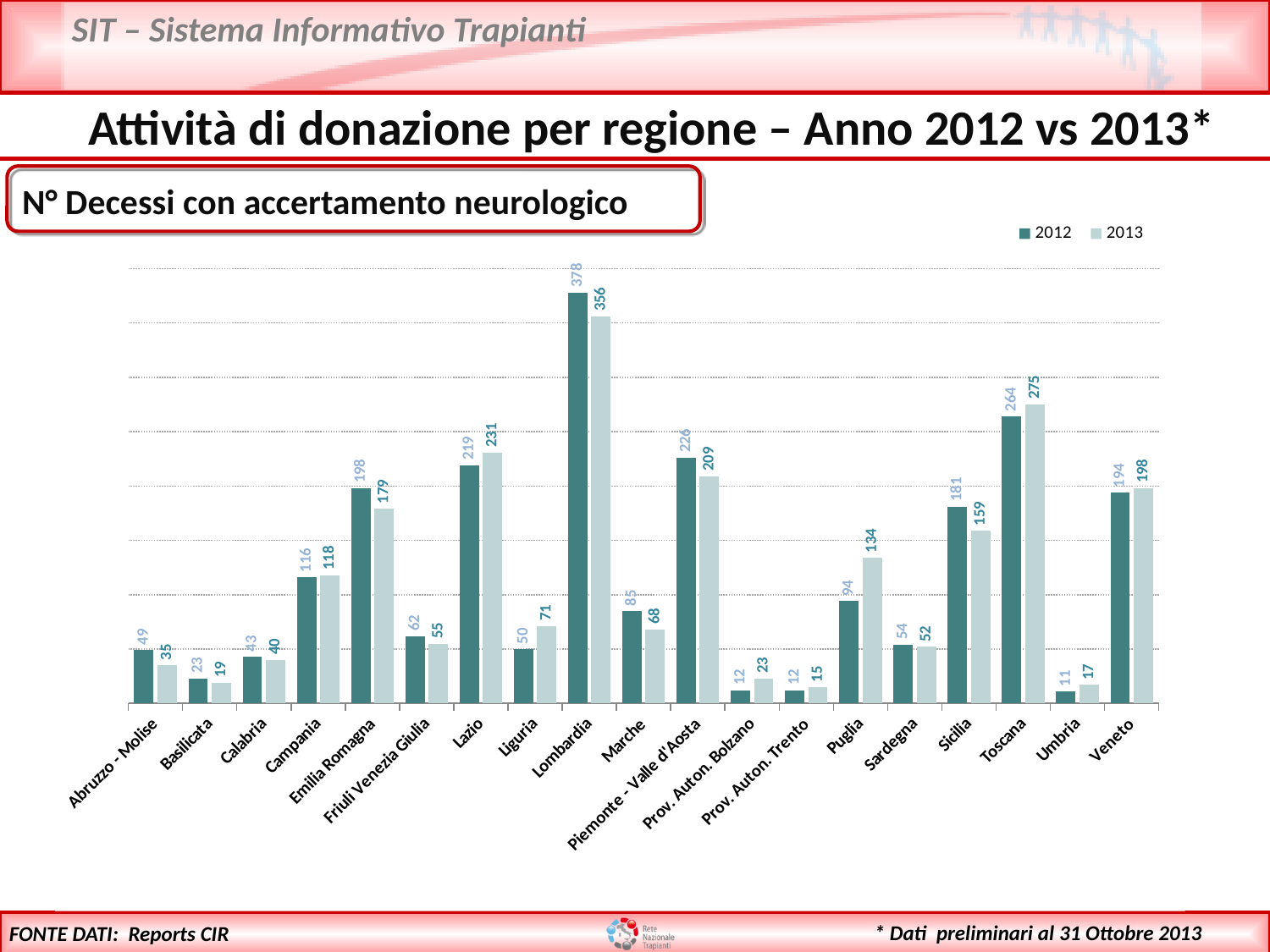
Which region has the lowest value in 2012? Umbria How many series does the legend list? 2 Which is larger for Sicilia, the 2012 value or the 2013 value? 2012 How many regions are shown on the x axis? 19 What is the difference between the 2012 and 2013 values for Lombardia? 22 Which region has the highest value in 2013? Lombardia What kind of chart is shown on the slide? Bar chart What is the difference between the 2013 and 2012 values for Puglia? 40 What is the value for Puglia in 2013? 134 What is the value for Lombardia in 2012? 378 What is the value for Toscana in 2013? 275 What are the two series listed in the legend? 2012 and 2013